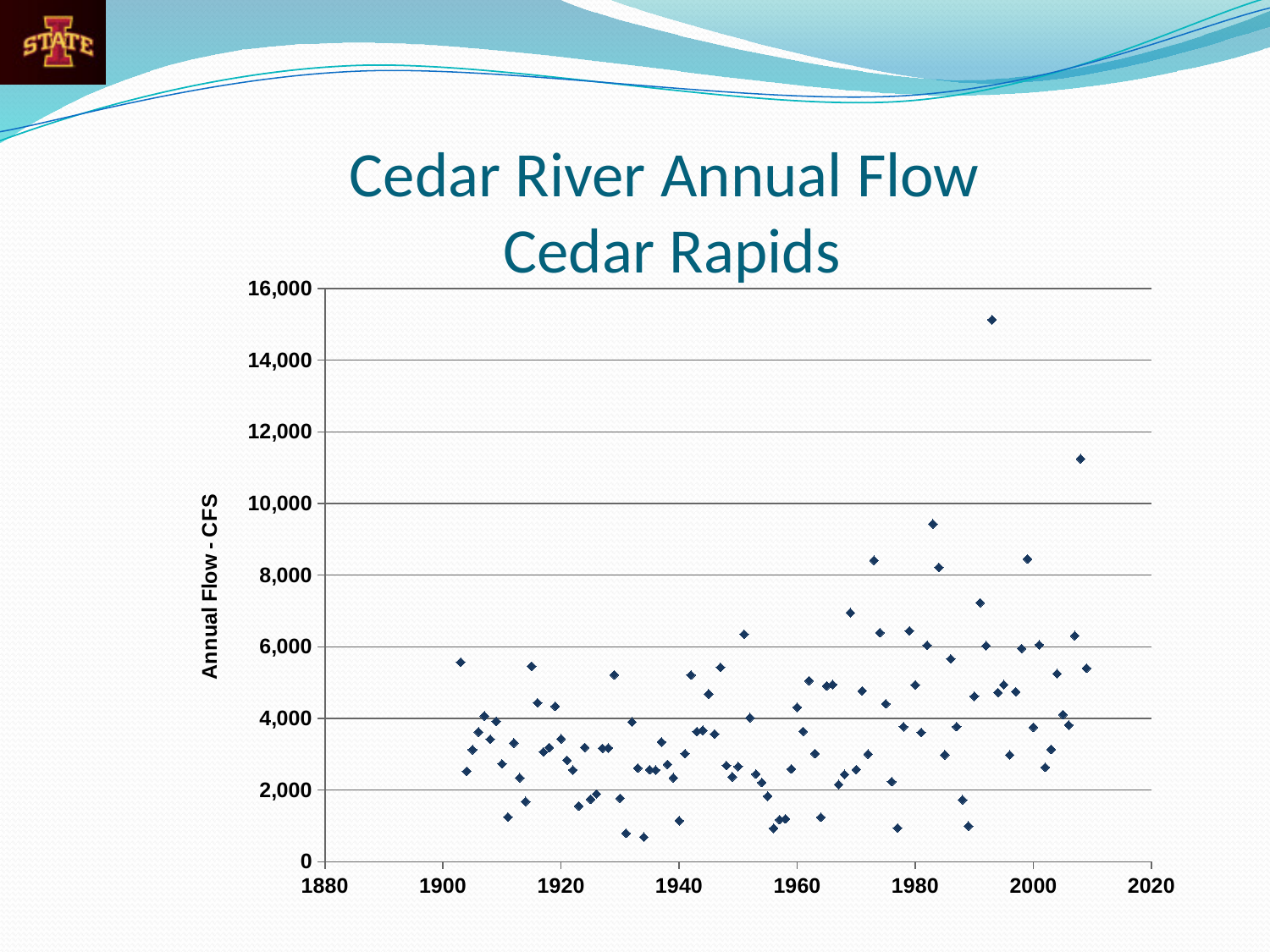
Which is larger: the highest point near 1993 or the highest point near 2008? the point near 1993 Is the second-highest plotted point (near 2008) greater or less than 10,000? greater Is the second-highest plotted point (near 2008) greater or less than 12,000? less Is the plotted value for the earliest year (around 1903) greater or less than 4,000? greater What kind of chart is shown on the slide? scatter plot What is the label on the vertical axis of the chart? Annual Flow - CFS What is the highest value shown on the vertical axis? 16,000 Does the highest plotted point occur before or after 1980? after What is the title of the chart? Cedar River Annual Flow Cedar Rapids